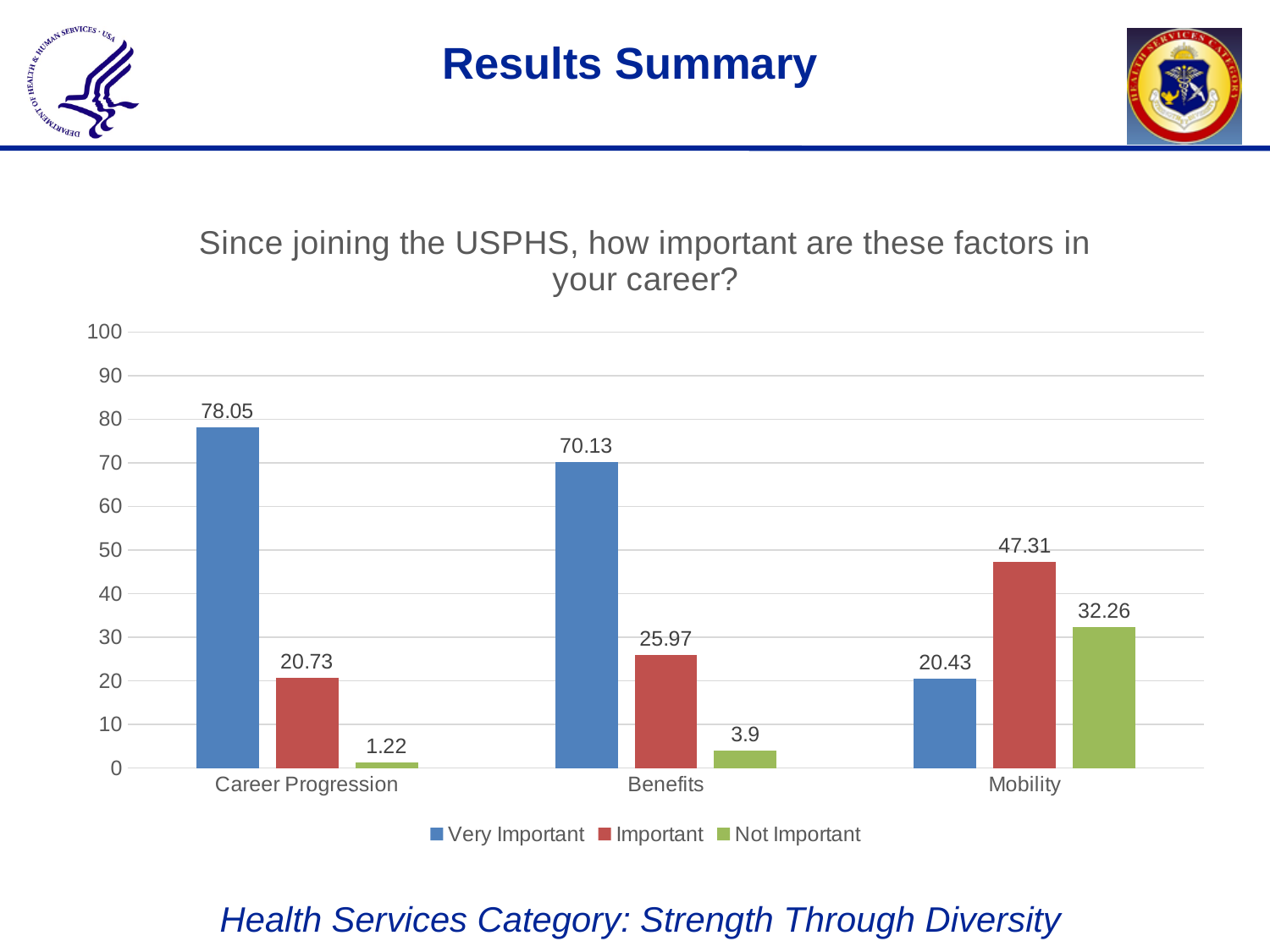
Which category has the lowest Not Important value? Career Progression What is the value for Not Important in the Benefits category? 3.9 Is the Very Important value for Mobility greater or less than 30? less What colour are the Not Important bars? green What is the difference between the Very Important and Important values for Benefits? 44.16 How many categories are shown on the x axis? 3 What is the value for Important in the Mobility category? 47.31 How many series does the legend list? 3 What is the value for Very Important in the Career Progression category? 78.05 Which is larger for Mobility: the Important value or the Not Important value? Important Which category has the highest Very Important value? Career Progression What kind of chart is shown on the slide? bar chart